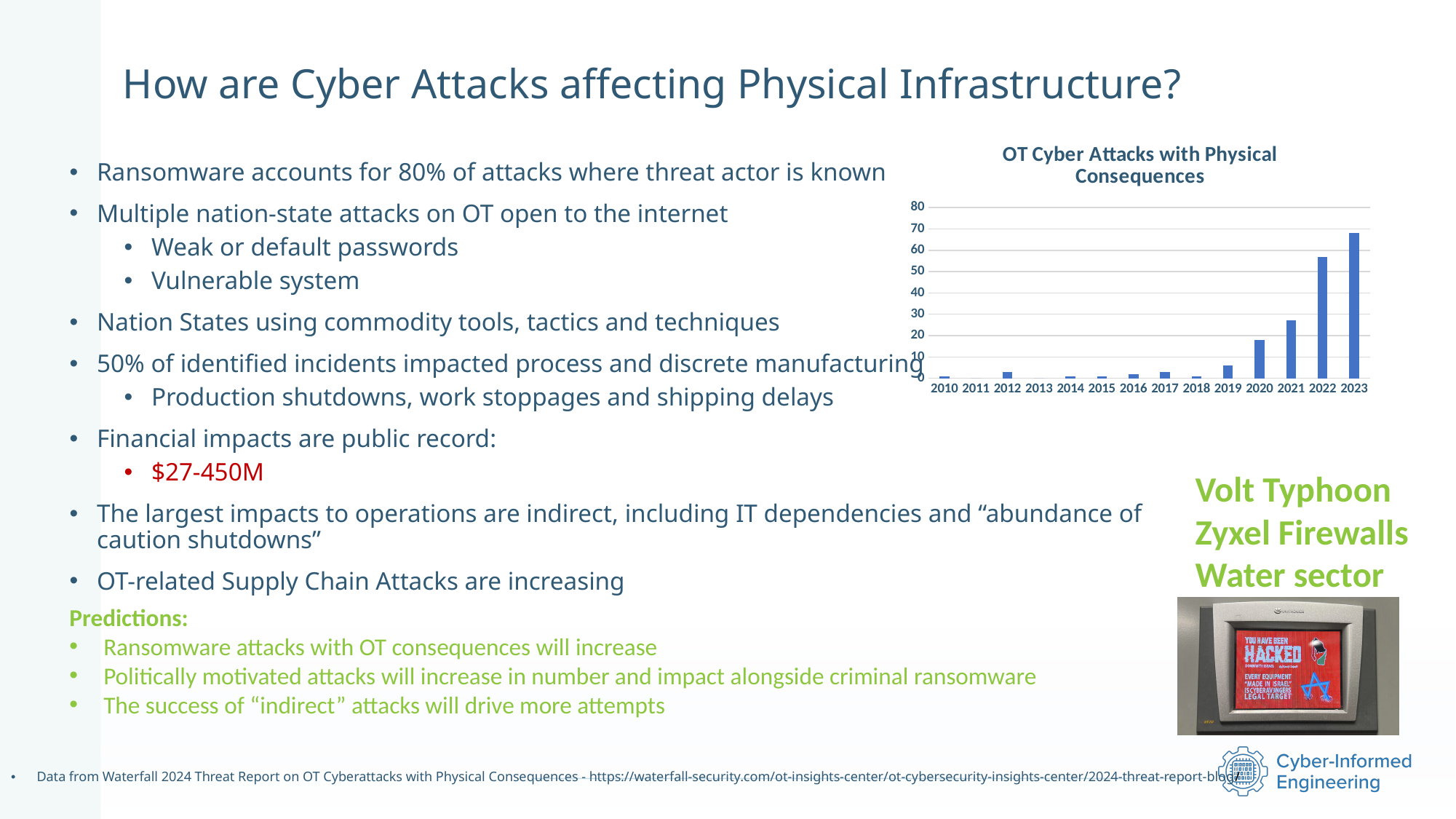
Which year has the highest number of OT cyber attacks with physical consequences? 2023 Is the value for 2020 greater or less than 10? greater Is the value for 2019 greater or less than 20? less How many years are shown on the x axis of the chart? 14 Is the value for 2023 greater or less than 60? greater Which year has the larger value, 2021 or 2022? 2022 What is the title of the chart on the slide? OT Cyber Attacks with Physical Consequences Which year has the larger value, 2019 or 2020? 2020 What kind of chart is shown on the slide? bar chart Do the values generally rise or fall from 2018 to 2023? rise